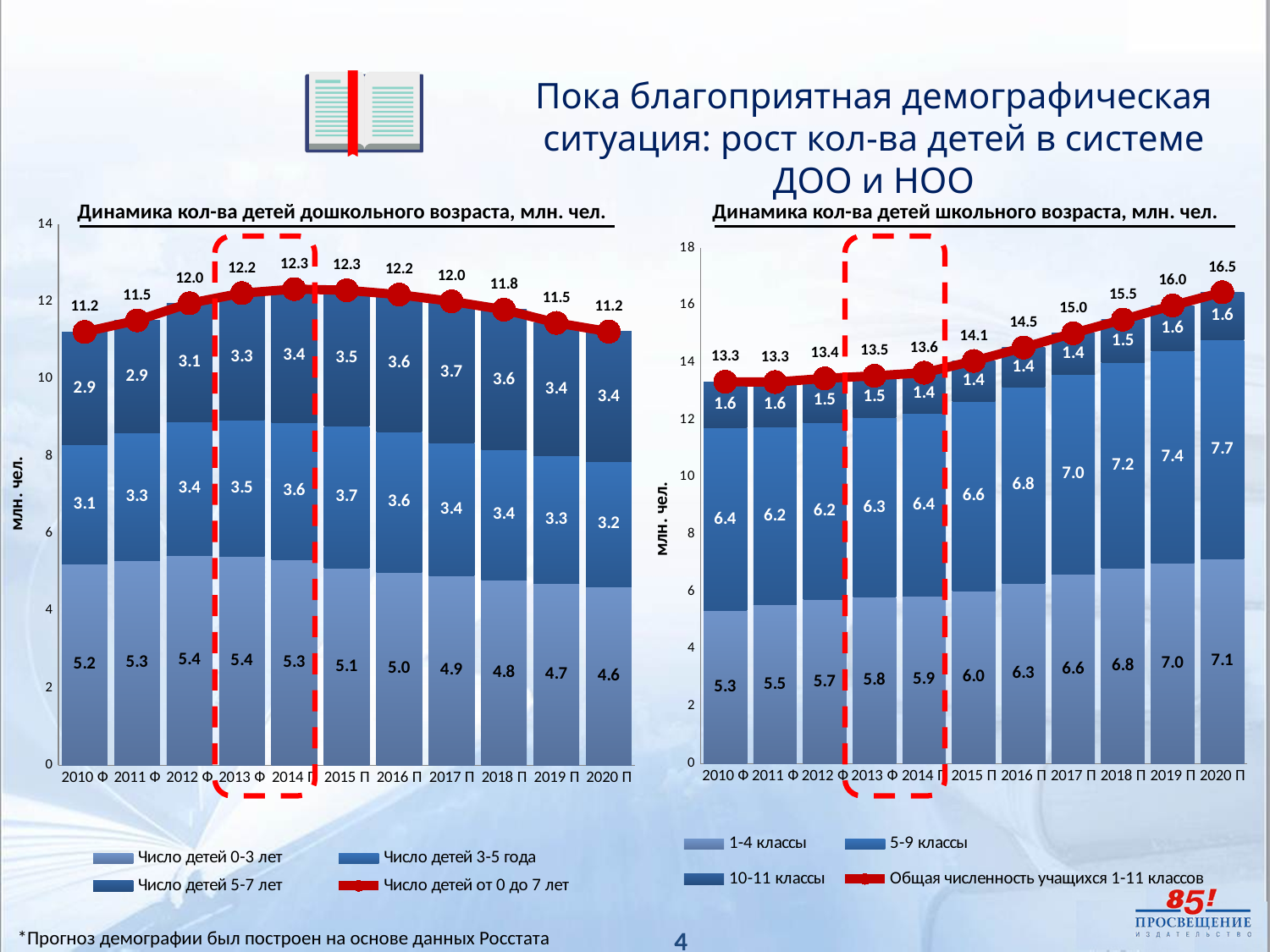
In the right chart (Динамика кол-ва детей школьного возраста), is the value for 5-9 классы larger in 2010 Ф or in 2011 Ф? 2010 Ф In the left chart (Динамика кол-ва детей дошкольного возраста), which year has the lowest value for Число детей 0-3 лет? 2020 П In the left chart (Динамика кол-ва детей дошкольного возраста), what is the difference between the Число детей 3-5 года values for 2015 П and 2010 Ф? 0.6 In the right chart (Динамика кол-ва детей школьного возраста), does the total number of students rise or fall from 2010 Ф to 2020 П? rise In the left chart (Динамика кол-ва детей дошкольного возраста), what is the total number of children from 0 to 7 years (line value) in 2014 П? 12.3 In the right chart (Динамика кол-ва детей школьного возраста), which year has the highest total number of students (line value)? 2020 П How many series does the legend of the left chart (Динамика кол-ва детей дошкольного возраста) list? 4 In the left chart (Динамика кол-ва детей дошкольного возраста), what is the value for Число детей 5-7 лет in 2017 П? 3.7 In the left chart (Динамика кол-ва детей дошкольного возраста), what is the value for Число детей 0-3 лет in 2010 Ф? 5.2 How many categories (years) are shown on the x axis of the right chart (Динамика кол-ва детей школьного возраста)? 11 In the right chart (Динамика кол-ва детей школьного возраста), what is the Общая численность учащихся 1-11 классов in 2016 П? 14.5 In the right chart (Динамика кол-ва детей школьного возраста), what is the value for 1-4 классы in 2020 П? 7.1